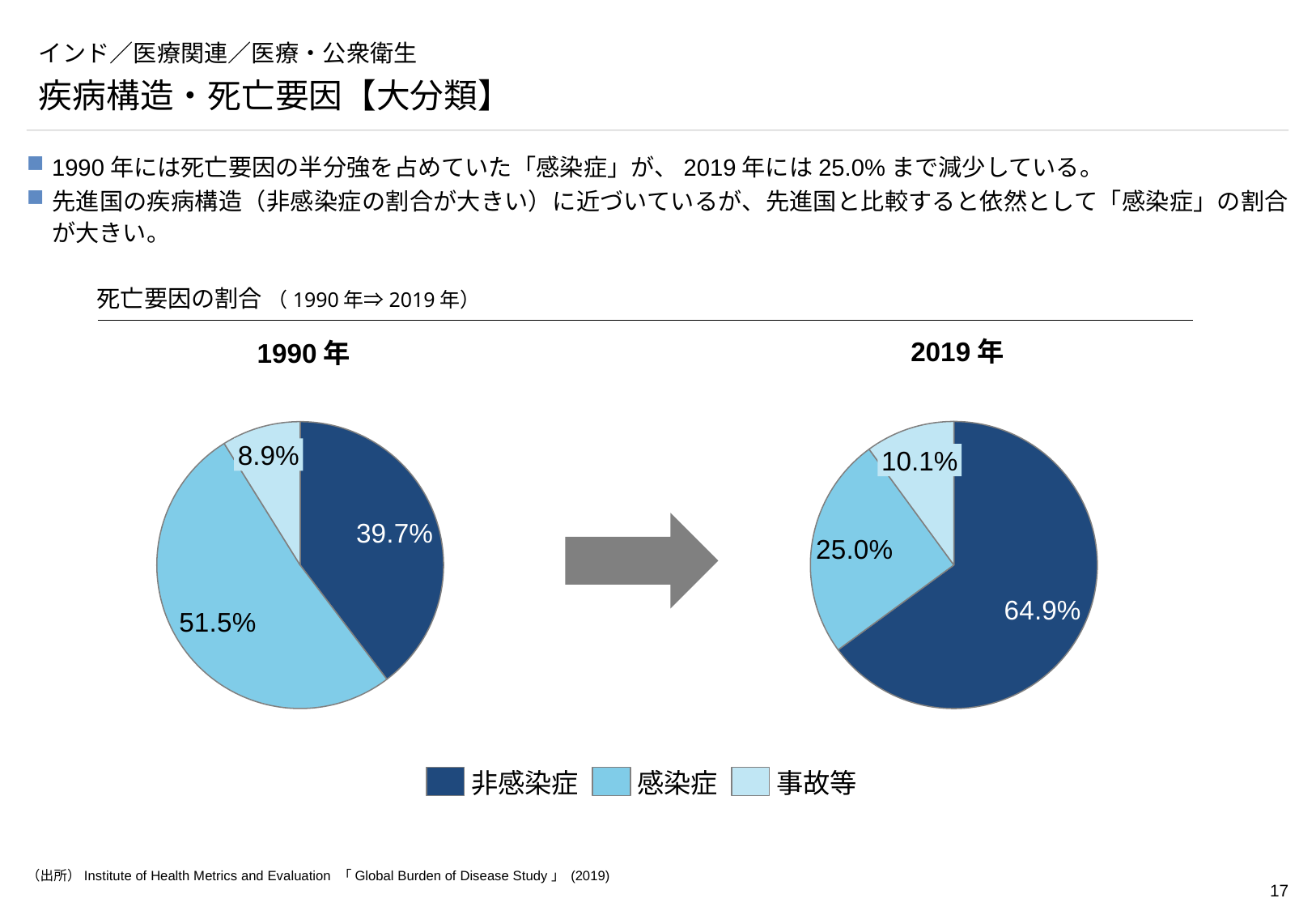
What type of chart is used to show 死亡要因の割合 for 1990年 and 2019年? Pie chart In the 2019年 pie chart, which category has the smallest share? 事故等 In the 1990年 pie chart, which category has the largest share? 感染症 In the 2019年 pie chart, what share is shown for 感染症? 25.0% How many categories does the legend list for the pie charts? 3 In the 2019年 pie chart, what share is shown for 非感染症? 64.9% In the 1990年 pie chart, which is larger, the share of 非感染症 or the share of 感染症? 感染症 In the 1990年 pie chart, what share is shown for 感染症? 51.5% In the 1990年 pie chart, what share is shown for 事故等? 8.9% In the 2019年 pie chart, what is the difference between the shares of 非感染症 and 感染症? 39.9% By how much did the share of 事故等 change from the 1990年 pie chart to the 2019年 pie chart? 1.2% Which category is shown in the darkest blue in the legend? 非感染症